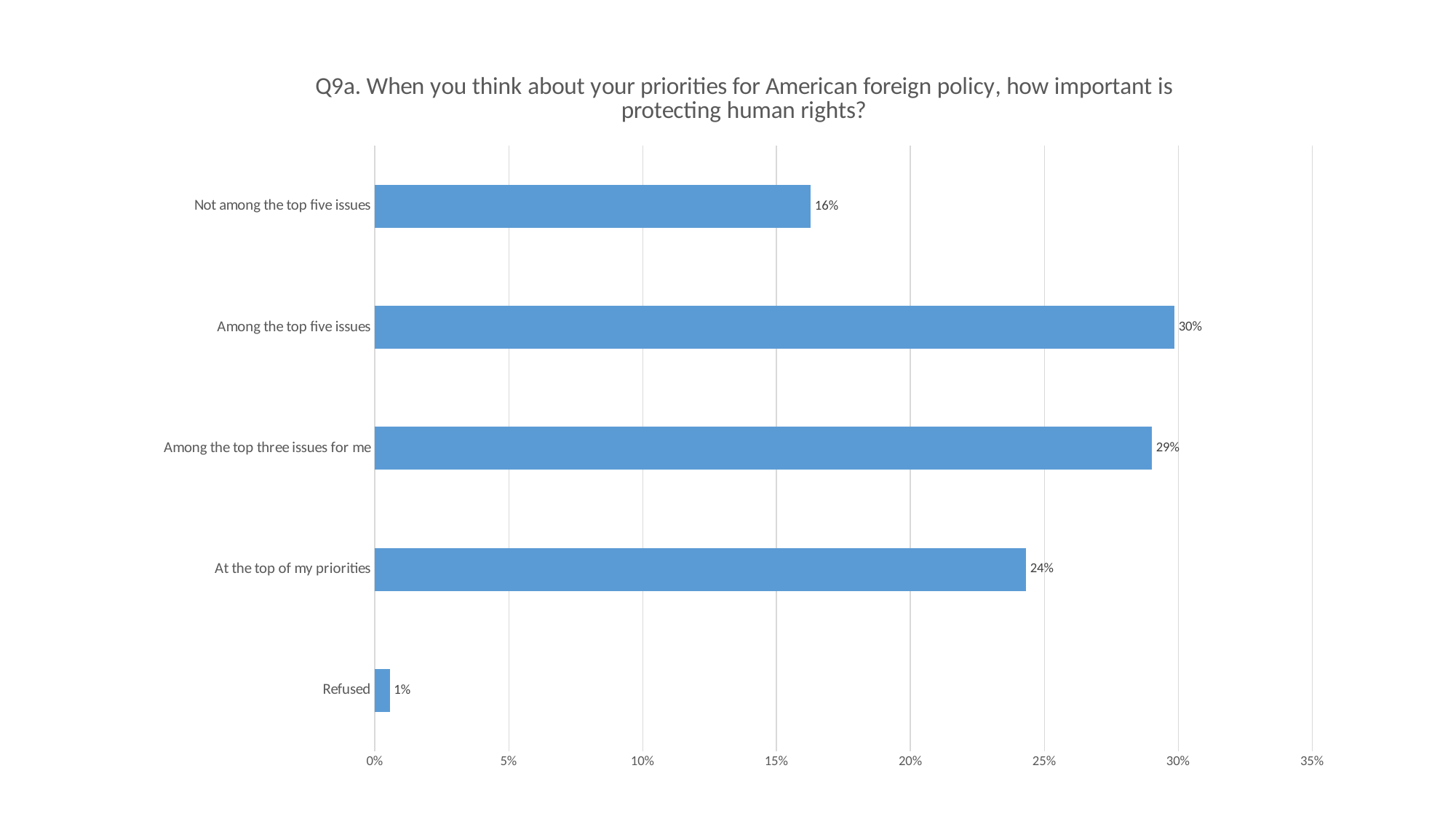
Is the value for "Among the top three issues for me" greater or less than 25%? greater Which category has the lowest value? Refused How many categories are shown in the chart? 5 What is the value for "Refused"? 1% What percentage is shown for "Not among the top five issues"? 16% What kind of chart is shown on the slide? Bar chart What is the difference between "Among the top three issues for me" and "At the top of my priorities"? 5% What is the difference between "Among the top five issues" and "Not among the top five issues"? 14% Which category has the highest value? Among the top five issues What percentage of respondents said protecting human rights is "Among the top five issues"? 30% What is the value for "At the top of my priorities"? 24% Which is larger: the value for "At the top of my priorities" or the value for "Not among the top five issues"? At the top of my priorities